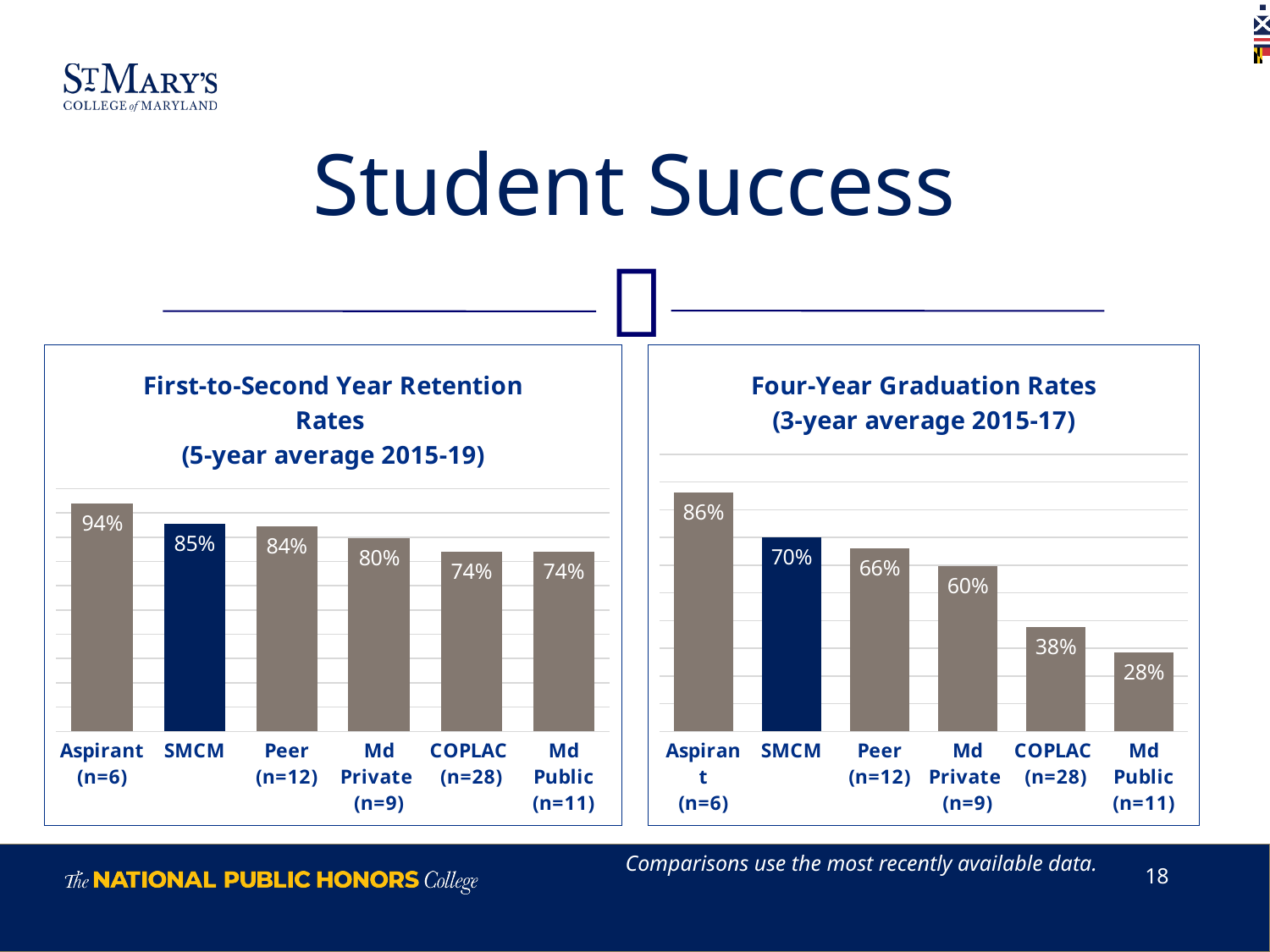
In the Four-Year Graduation Rates chart, which category has the highest value? Aspirant (n=6) How many categories are shown in the Four-Year Graduation Rates chart? 6 In the Four-Year Graduation Rates chart, what is the difference between the SMCM value and the Peer (n=12) value? 4% What kind of chart is the First-to-Second Year Retention Rates chart? Bar chart In the First-to-Second Year Retention Rates chart, which is larger, the value for Peer (n=12) or the value for Md Private (n=9)? Peer (n=12) In the First-to-Second Year Retention Rates chart, what is the value for SMCM? 85% In the Four-Year Graduation Rates chart, which category has the lowest value? Md Public (n=11) In the Four-Year Graduation Rates chart, which is larger, the value for COPLAC (n=28) or the value for Md Public (n=11)? COPLAC (n=28) In the First-to-Second Year Retention Rates chart, which category has the highest value? Aspirant (n=6) In the Four-Year Graduation Rates chart, what is the value for Md Private (n=9)? 60% In the Four-Year Graduation Rates chart, do the values rise or fall from left to right across the categories? Fall In the First-to-Second Year Retention Rates chart, what is the difference between the Aspirant value and the SMCM value? 9%